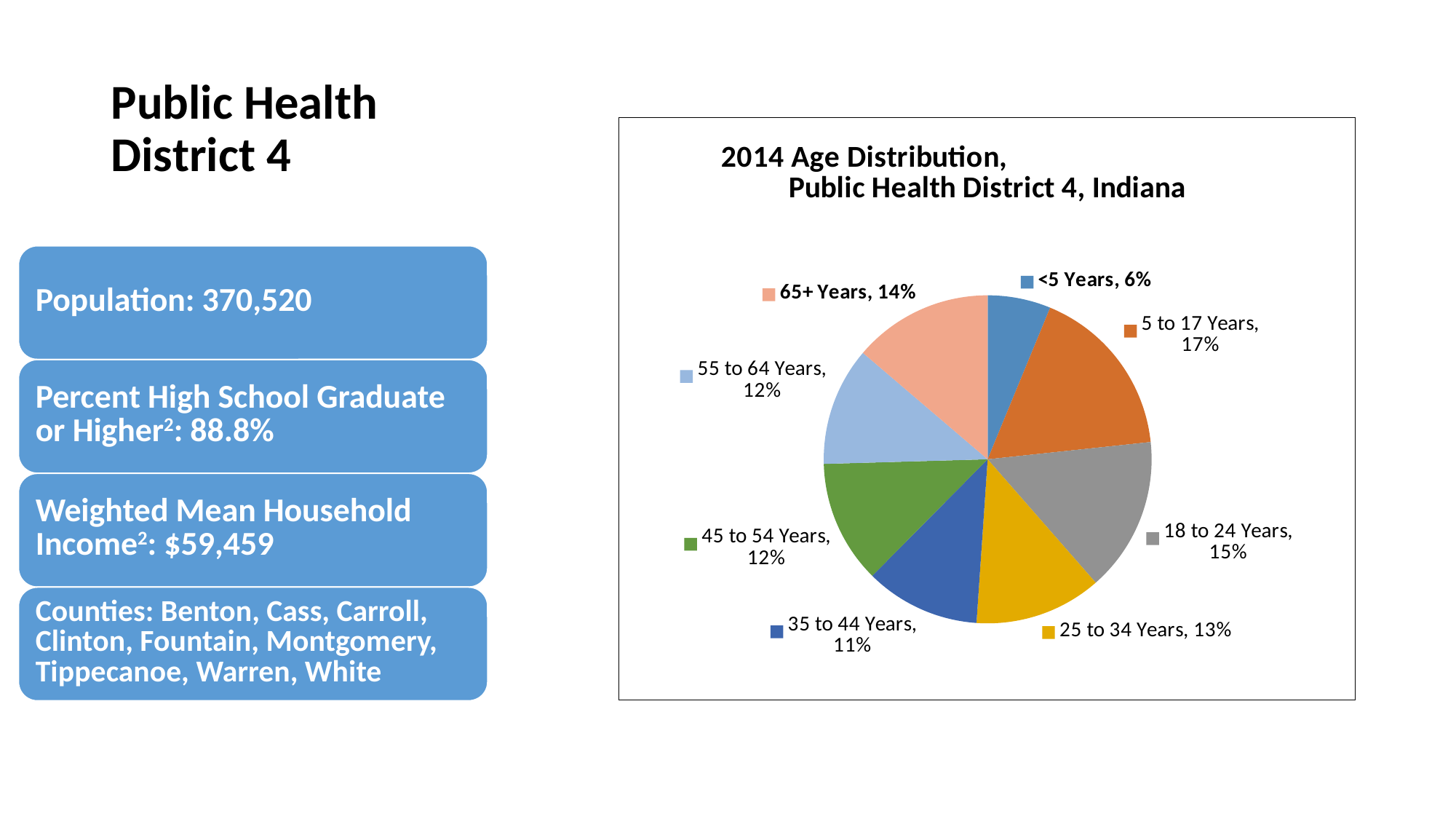
How many age groups are shown in the pie chart? 8 What type of chart is shown on the slide? pie chart What percentage of the population is in the 35 to 44 Years group? 11% What is the title of the chart? 2014 Age Distribution, Public Health District 4, Indiana Which age group has the largest share of the pie? 5 to 17 Years What percentage of the population is in the 5 to 17 Years group? 17% Which age group has the smallest share of the pie? <5 Years What colour is the slice for 18 to 24 Years? gray What is the difference in percentage points between the 18 to 24 Years group and the <5 Years group? 9 What is the combined share of the 45 to 54 Years and 55 to 64 Years groups? 24% What percentage of the population is 65+ Years? 14% Which is larger, the share for 25 to 34 Years or the share for 55 to 64 Years? 25 to 34 Years